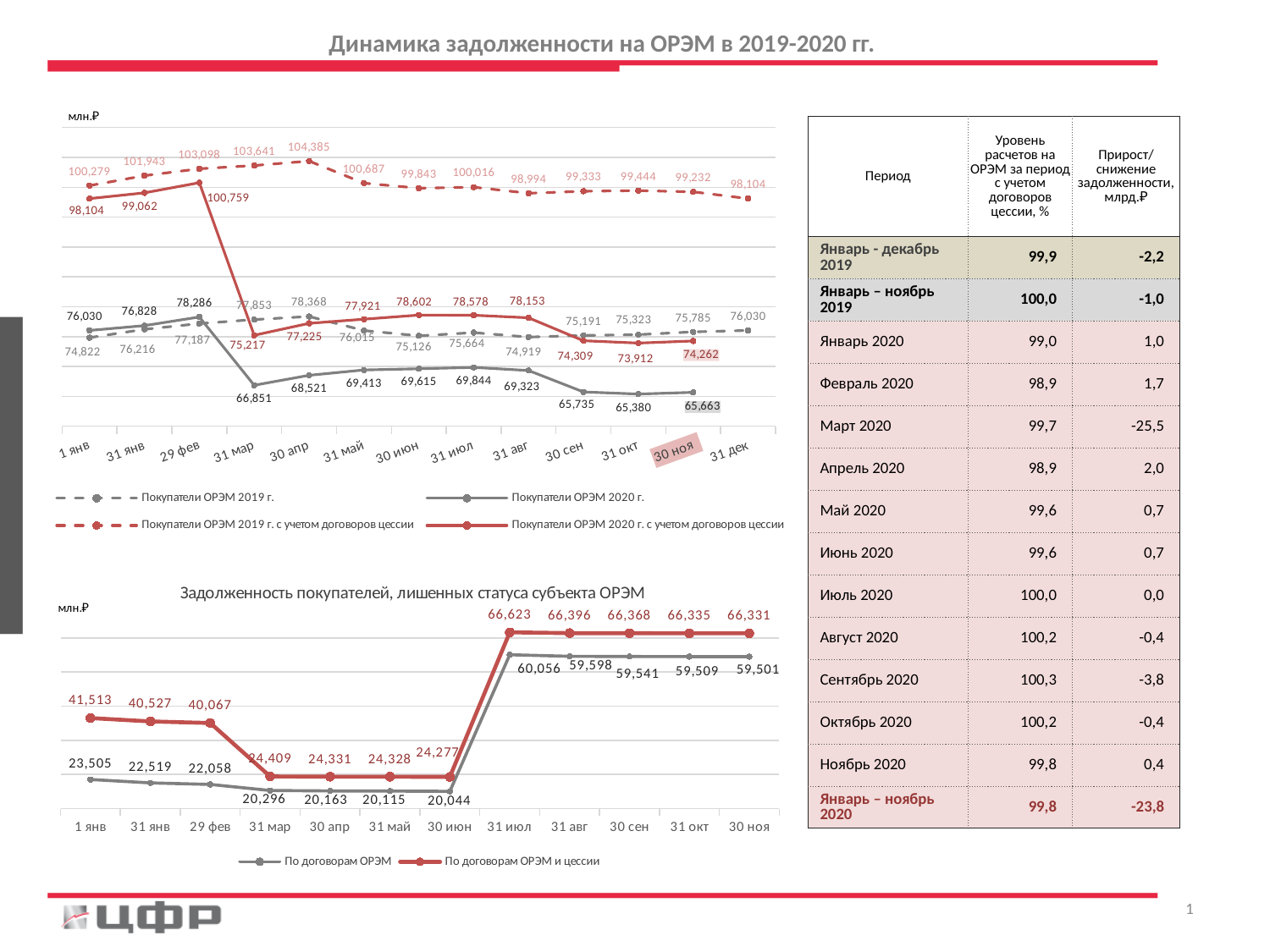
On the bottom chart titled 'Задолженность покупателей, лишенных статуса субъекта ОРЭМ', which date has the lowest value for 'По договорам ОРЭМ'? 30 июн On the bottom chart titled 'Задолженность покупателей, лишенных статуса субъекта ОРЭМ', what is the value for 'По договорам ОРЭМ' on 1 янв? 23,505 On the bottom chart titled 'Задолженность покупателей, лишенных статуса субъекта ОРЭМ', how many dates are shown on the x axis? 12 On the bottom chart titled 'Задолженность покупателей, лишенных статуса субъекта ОРЭМ', what is the difference between the two series on 30 ноя? 6,830 On the top chart, how many series does the legend list? 4 What kind of chart is the top chart on the slide? Line chart On the top chart, what is the value for 'Покупатели ОРЭМ 2020 г.' on 31 мар? 66,851 On the bottom chart titled 'Задолженность покупателей, лишенных статуса субъекта ОРЭМ', what is the value for 'По договорам ОРЭМ и цессии' on 31 июл? 66,623 On the top chart, which is larger on 30 ноя: 'Покупатели ОРЭМ 2019 г.' or 'Покупатели ОРЭМ 2020 г.'? Покупатели ОРЭМ 2019 г. On the top chart, what is the value for 'Покупатели ОРЭМ 2020 г. с учетом договоров цессии' on 29 фев? 100,759 On the top chart, which date has the highest value for 'Покупатели ОРЭМ 2019 г. с учетом договоров цессии'? 30 апр On the bottom chart titled 'Задолженность покупателей, лишенных статуса субъекта ОРЭМ', how many series does the legend list? 2